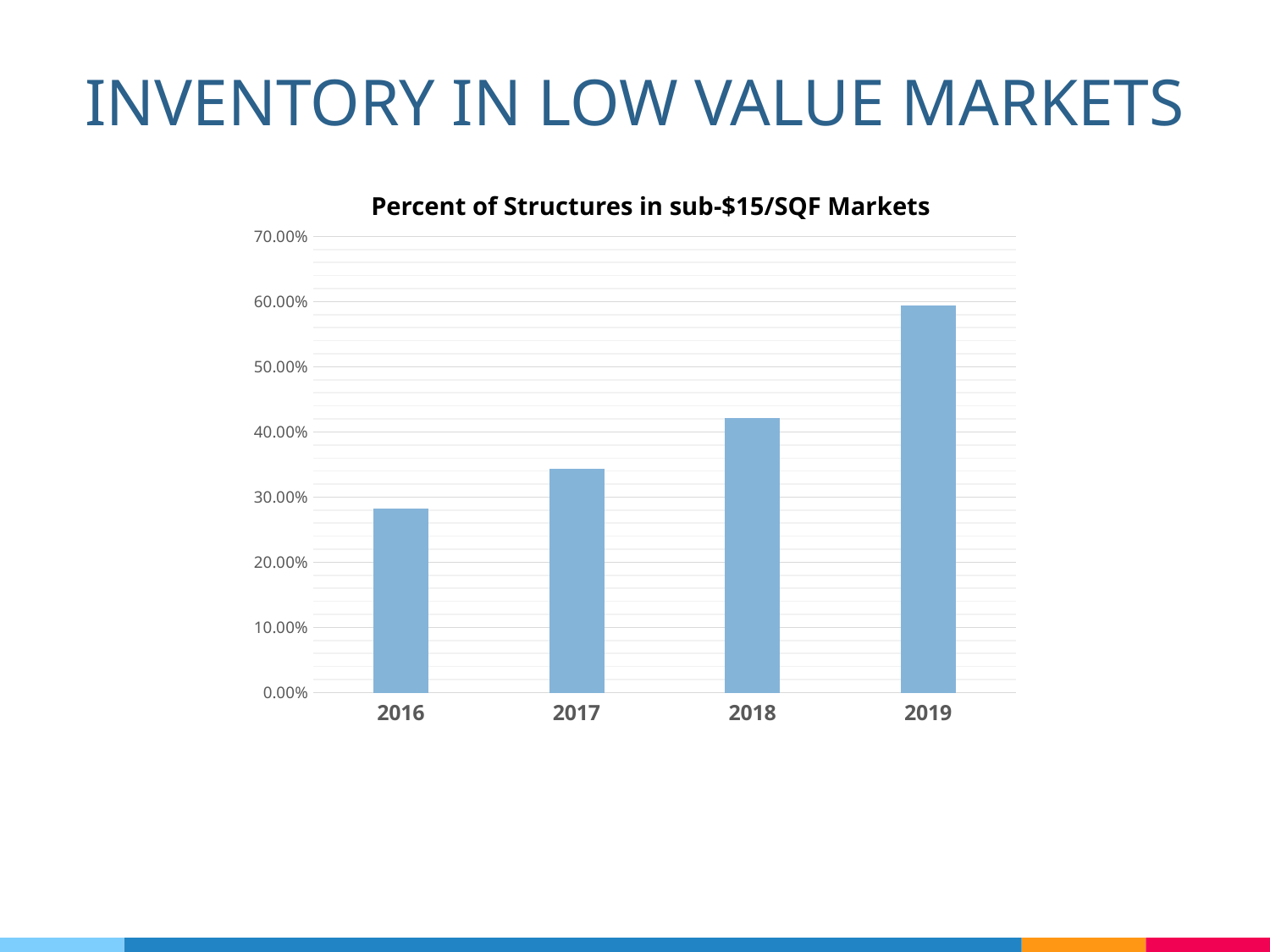
What is the title of the chart? Percent of Structures in sub-$15/SQF Markets What is the highest value shown on the y axis of the chart? 70.00% Which year has the larger value, 2017 or 2018? 2018 Is the value for 2018 greater or less than 40.00%? greater Do the values rise or fall from 2016 to 2019? rise How many years are shown on the x axis of the chart? 4 Which year has the lowest percent of structures in sub-$15/SQF markets? 2016 What kind of chart is shown on the slide? bar chart Is the value for 2016 greater or less than 30.00%? less Is the value for 2017 greater or less than 30.00%? greater Which year has the highest percent of structures in sub-$15/SQF markets? 2019